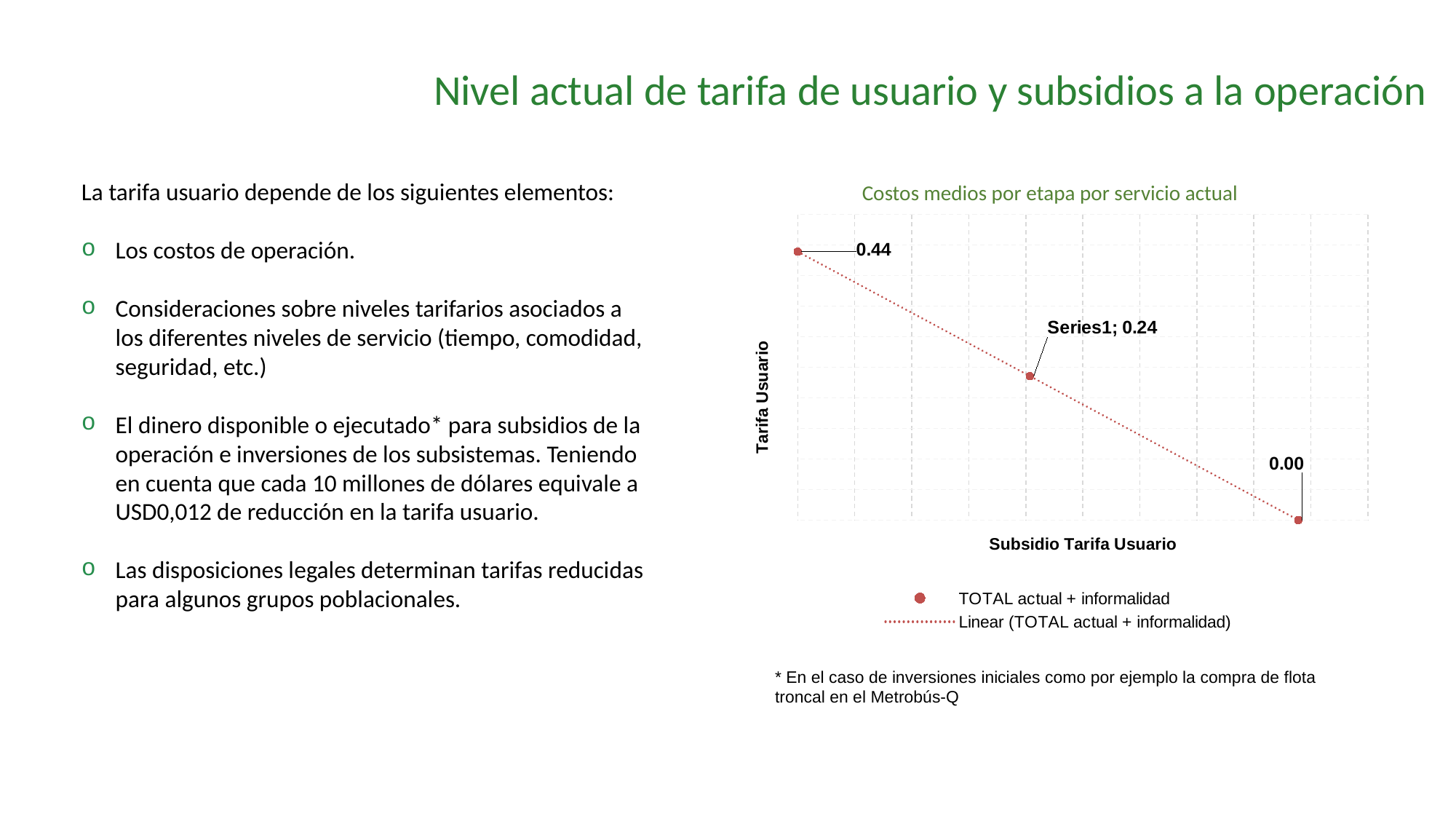
How many data points are plotted in the chart? 3 What is the lowest value labelled on the chart? 0.00 What is the difference between the leftmost point (0.44) and the middle point (0.24)? 0.20 What is the value of the leftmost data point in the chart? 0.44 How many entries does the chart legend list? 2 What kind of chart is shown on the slide? Scatter chart What is the highest value labelled on the chart? 0.44 What is the value of the middle data point in the chart? 0.24 What is the title of the vertical axis of the chart? Tarifa Usuario What is the value of the rightmost data point in the chart? 0.00 What is the title of the chart? Costos medios por etapa por servicio actual Do the plotted values rise or fall as Subsidio Tarifa Usuario increases along the x axis? Fall